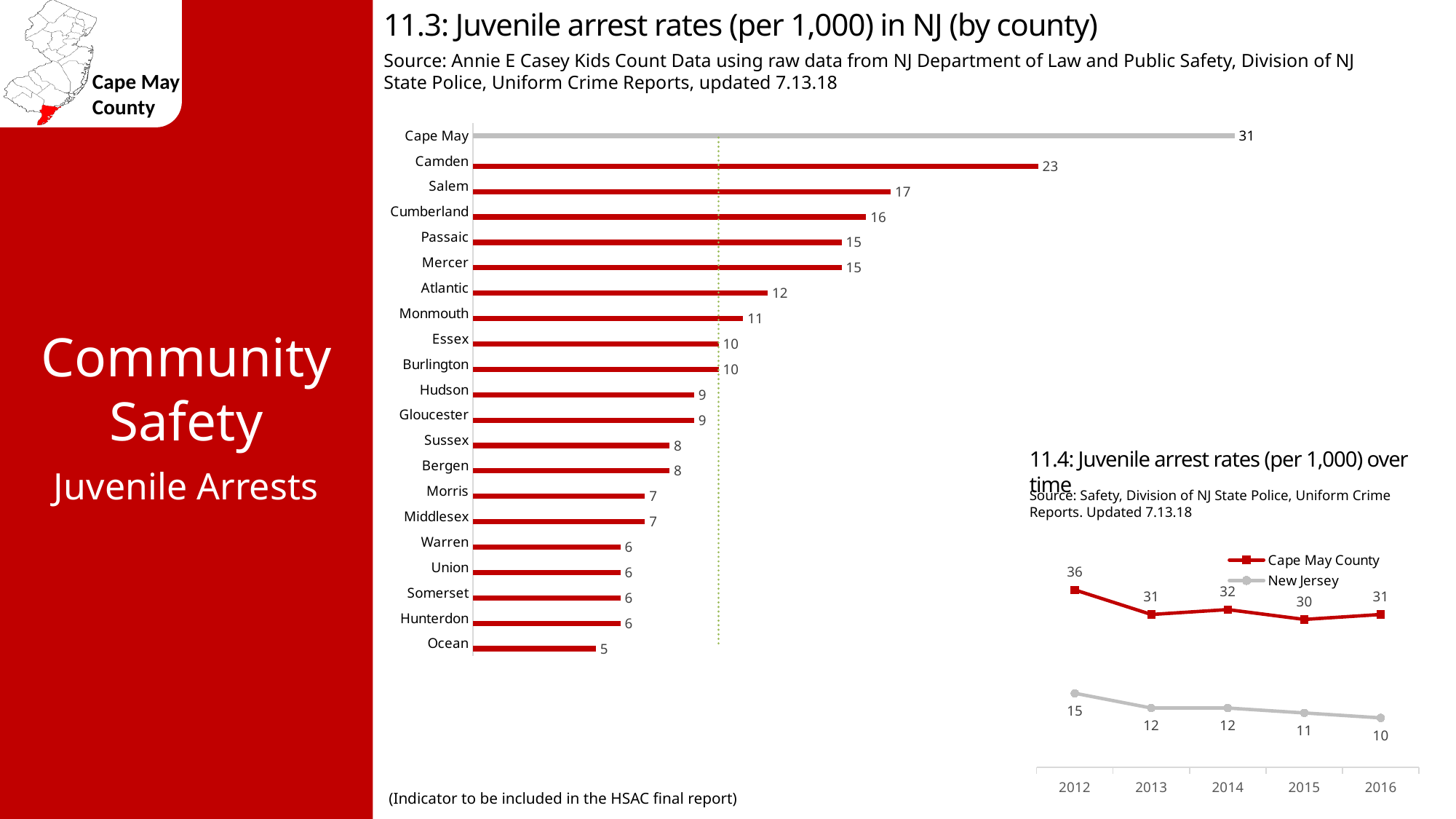
How many counties are shown in the chart '11.3: Juvenile arrest rates (per 1,000) in NJ (by county)'? 21 In the chart '11.3: Juvenile arrest rates (per 1,000) in NJ (by county)', what is the value for Atlantic? 12 In the chart '11.3: Juvenile arrest rates (per 1,000) in NJ (by county)', what is the value for Camden? 23 What kind of chart is '11.3: Juvenile arrest rates (per 1,000) in NJ (by county)'? Bar chart In the chart '11.3: Juvenile arrest rates (per 1,000) in NJ (by county)', which county has the lowest value? Ocean In the chart '11.3: Juvenile arrest rates (per 1,000) in NJ (by county)', what is the difference between the values for Cape May and Camden? 8 In the chart '11.4: Juvenile arrest rates (per 1,000) over time', what is the value for Cape May County in 2012? 36 In the chart '11.3: Juvenile arrest rates (per 1,000) in NJ (by county)', which county has the highest value? Cape May In the chart '11.3: Juvenile arrest rates (per 1,000) in NJ (by county)', which has a larger value, Salem or Passaic? Salem In the chart '11.4: Juvenile arrest rates (per 1,000) over time', what is the value for New Jersey in 2016? 10 In the chart '11.4: Juvenile arrest rates (per 1,000) over time', what is the difference between Cape May County and New Jersey in 2014? 20 How many series does the legend list in the chart '11.4: Juvenile arrest rates (per 1,000) over time'? 2